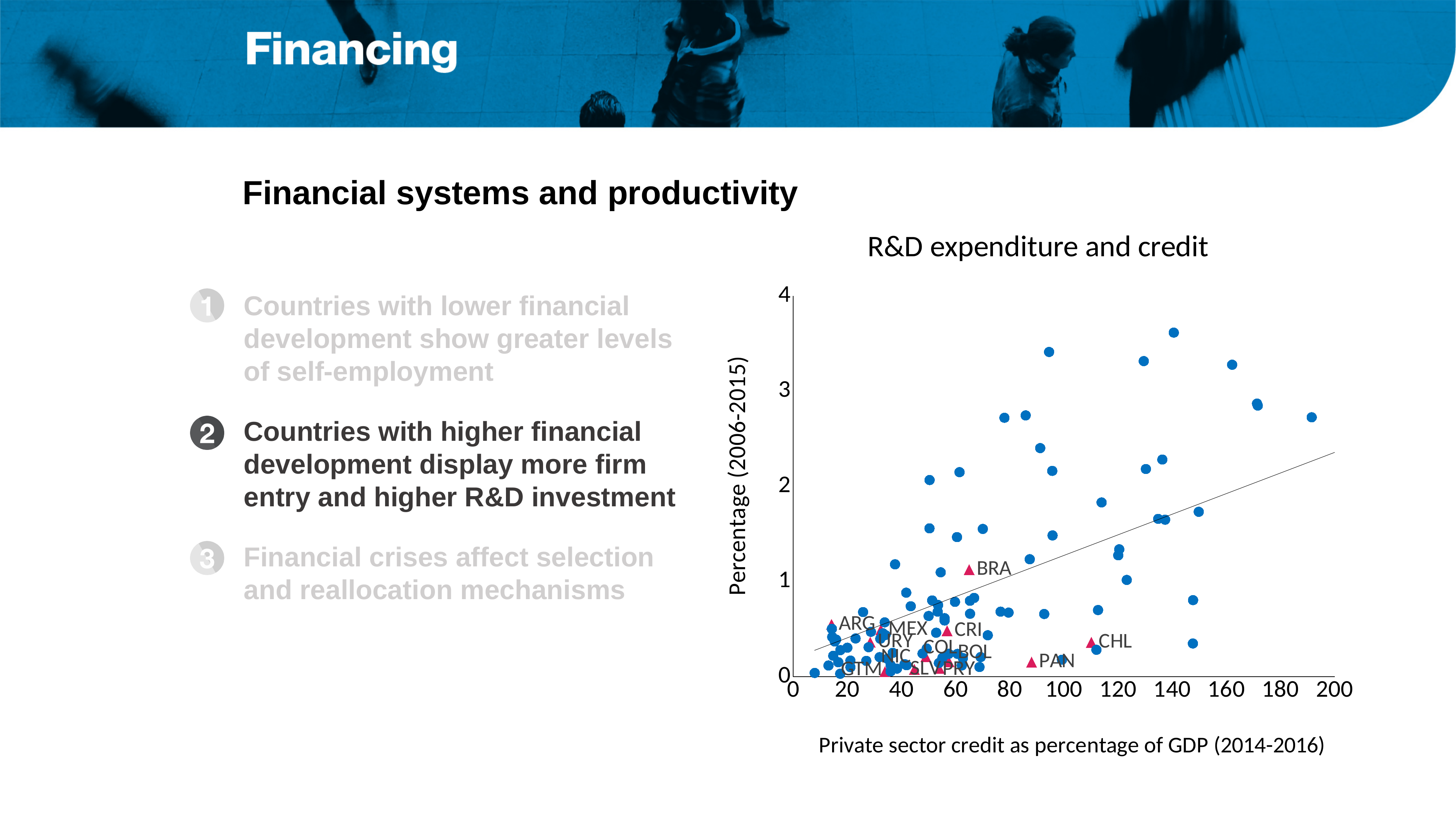
Which has the higher private sector credit value, CHL or ARG? CHL Among the labelled countries, which has the highest R&D percentage? BRA According to the fitted line, does the R&D percentage rise or fall as private sector credit increases? Rise Is the R&D percentage value for PAN greater or less than 1? less What is the label of the horizontal axis of the chart? Private sector credit as percentage of GDP (2014-2016) What kind of chart is shown on the slide? Scatter chart Which has the higher R&D percentage, BRA or PAN? BRA Is the private sector credit value for PAN greater or less than 80? greater What is the title of the chart? R&D expenditure and credit Is the private sector credit value for ARG greater or less than 20? less